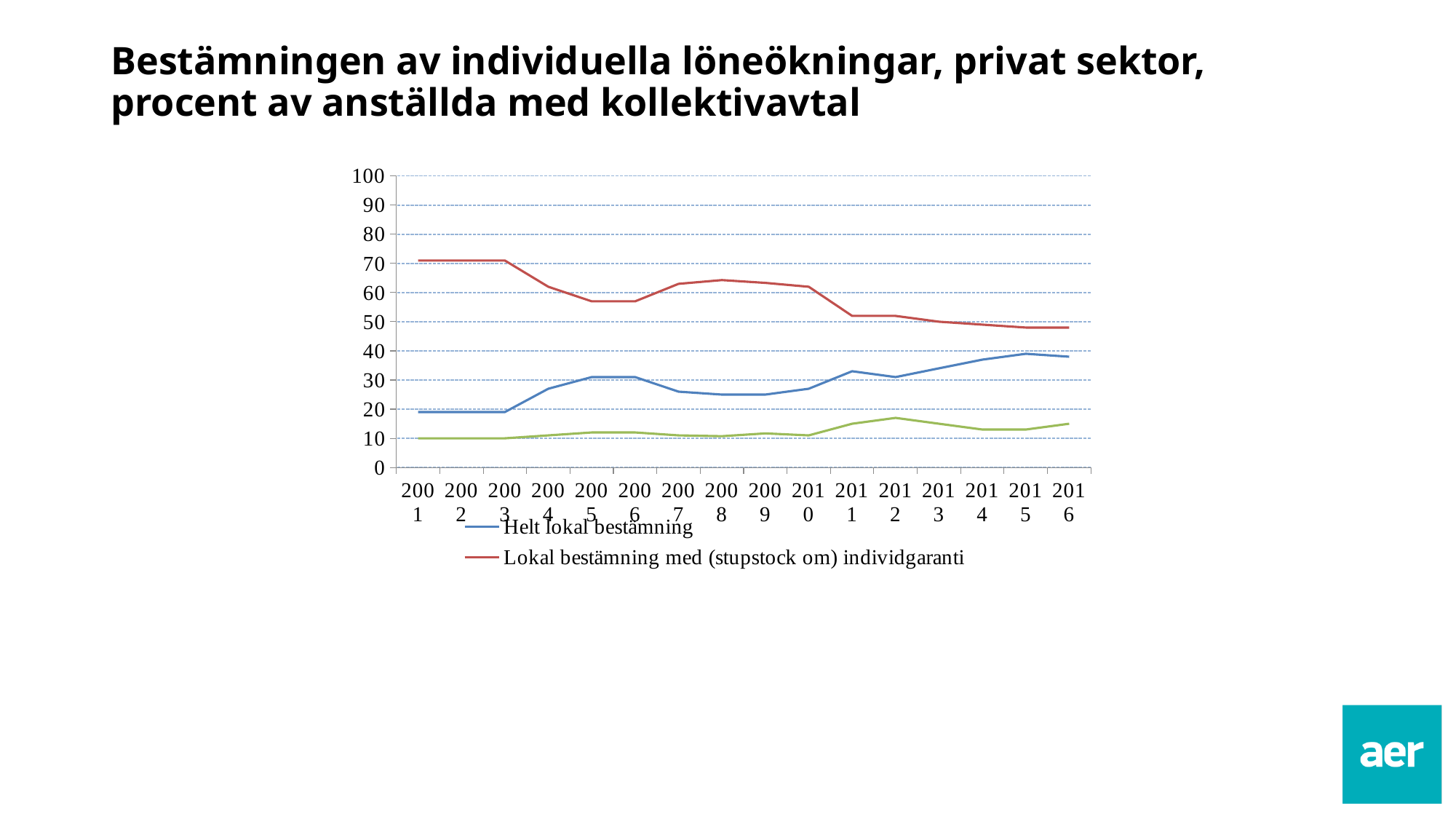
What colour is the line for 'Helt lokal bestämning'? blue Is the value for 'Lokal bestämning med (stupstock om) individgaranti' in 2001 greater or less than 60? greater In 2016, which is larger: 'Helt lokal bestämning' or 'Lokal bestämning med (stupstock om) individgaranti'? Lokal bestämning med (stupstock om) individgaranti Does the value for 'Lokal bestämning med (stupstock om) individgaranti' rise or fall from 2001 to 2016? fall Is the value for 'Lokal bestämning med (stupstock om) individgaranti' in 2016 greater or less than 50? less What kind of chart is shown on the slide? line chart Is the value for 'Helt lokal bestämning' in 2016 greater or less than 40? less Which series has the highest value in 2001? Lokal bestämning med (stupstock om) individgaranti How many series does the legend list? 2 Does the value for 'Helt lokal bestämning' rise or fall from 2001 to 2016? rise How many years are shown on the x axis? 16